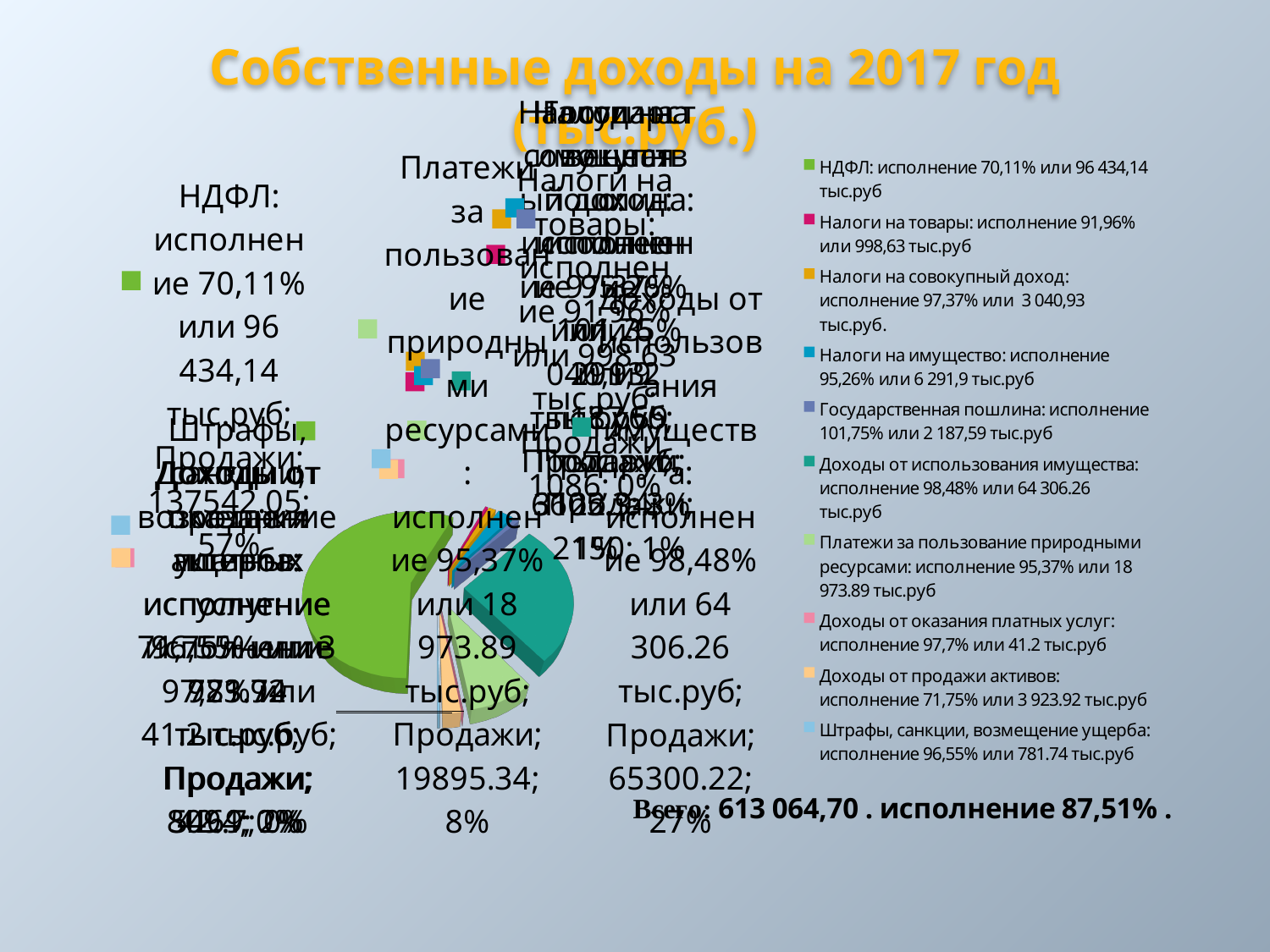
What overall execution percentage (исполнение) is printed next to the total? 87,51% According to the legend text, what is the execution percentage for НДФЛ? 70,11% Which category has the largest slice of the pie? НДФЛ According to the legend text, what is the execution percentage for Государственная пошлина? 101,75% What share of the pie does НДФЛ take? 57% What share of the pie do Доходы от использования имущества take? 27% How many entries does the legend on the right list? 10 Which slice is larger: НДФЛ or Платежи за пользование природными ресурсами? НДФЛ What total (Всего) is printed at the bottom of the slide? 613 064,70 What is the title of the chart? Собственные доходы на 2017 год (тыс.руб.) What kind of chart is shown on the slide? pie chart What share of the pie do Платежи за пользование природными ресурсами take? 8%